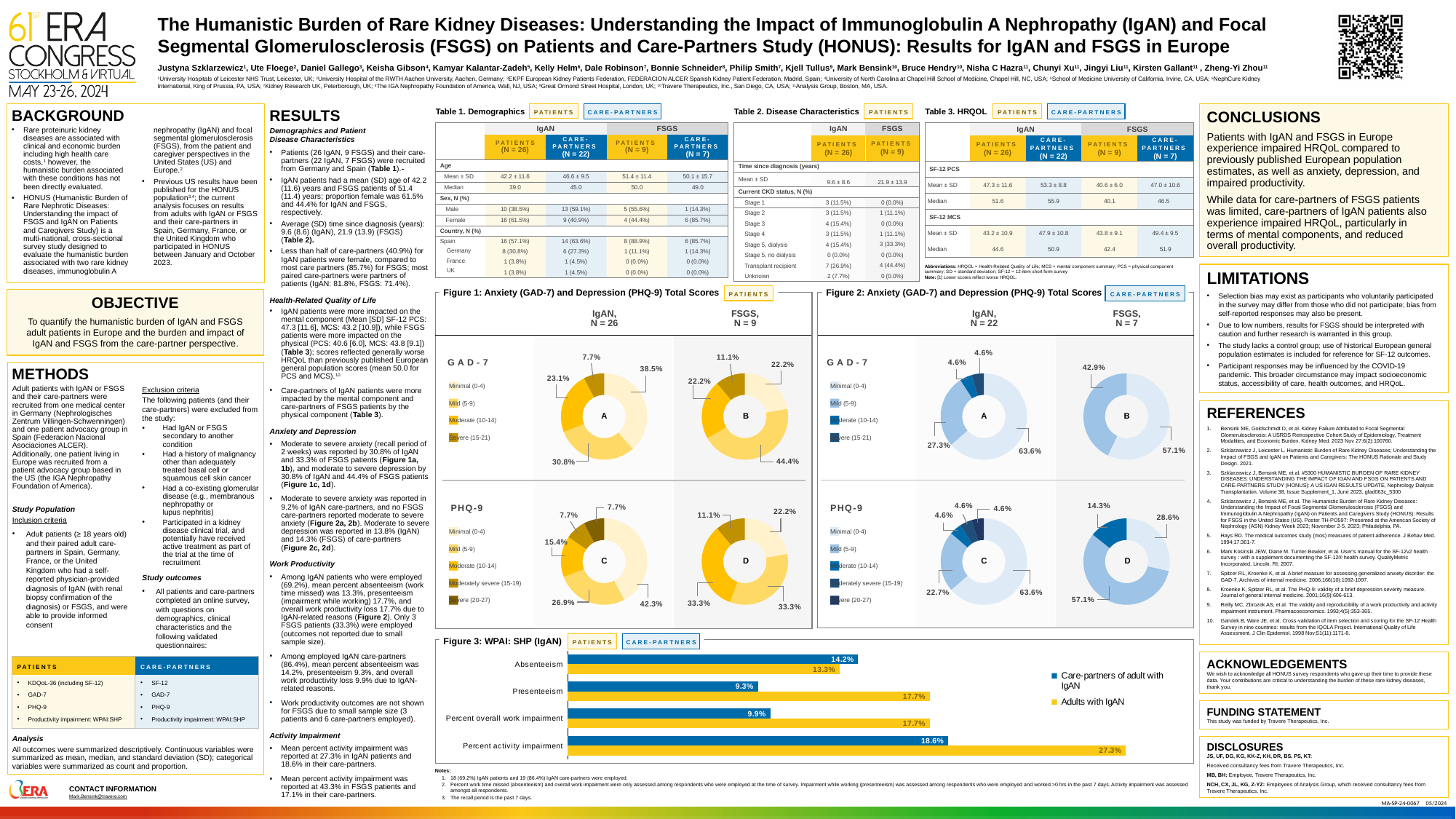
In Figure 3 (WPAI: SHP, IgAN), which is larger for absenteeism: the value for adults with IgAN or for care-partners of adults with IgAN? Care-partners of adults with IgAN In Figure 3 (WPAI: SHP, IgAN), what is the difference between the percent activity impairment for adults with IgAN and for care-partners of adults with IgAN? 8.7% In Figure 3 (WPAI: SHP, IgAN), what is the absenteeism value for care-partners of adults with IgAN? 14.2% In Figure 3 (WPAI: SHP, IgAN), which category has the lowest value for care-partners of adults with IgAN? Presenteeism In Figure 1 (patients), what is the largest slice in the GAD-7 donut for IgAN (N = 26)? 38.5% In Figure 2 (care-partners), what is the largest slice in the PHQ-9 donut for FSGS (N = 7)? 57.1% In Figure 3 (WPAI: SHP, IgAN), what is the presenteeism value for adults with IgAN? 17.7% In Figure 3 (WPAI: SHP, IgAN), how many categories are shown on the axis? 4 In Figure 3 (WPAI: SHP, IgAN), which category has the highest value for adults with IgAN? Percent activity impairment What kind of chart is Figure 3 (WPAI: SHP, IgAN)? Bar chart In Figure 3 (WPAI: SHP, IgAN), what is the percent activity impairment for adults with IgAN? 27.3% In Figure 3 (WPAI: SHP, IgAN), how many series does the legend list? 2